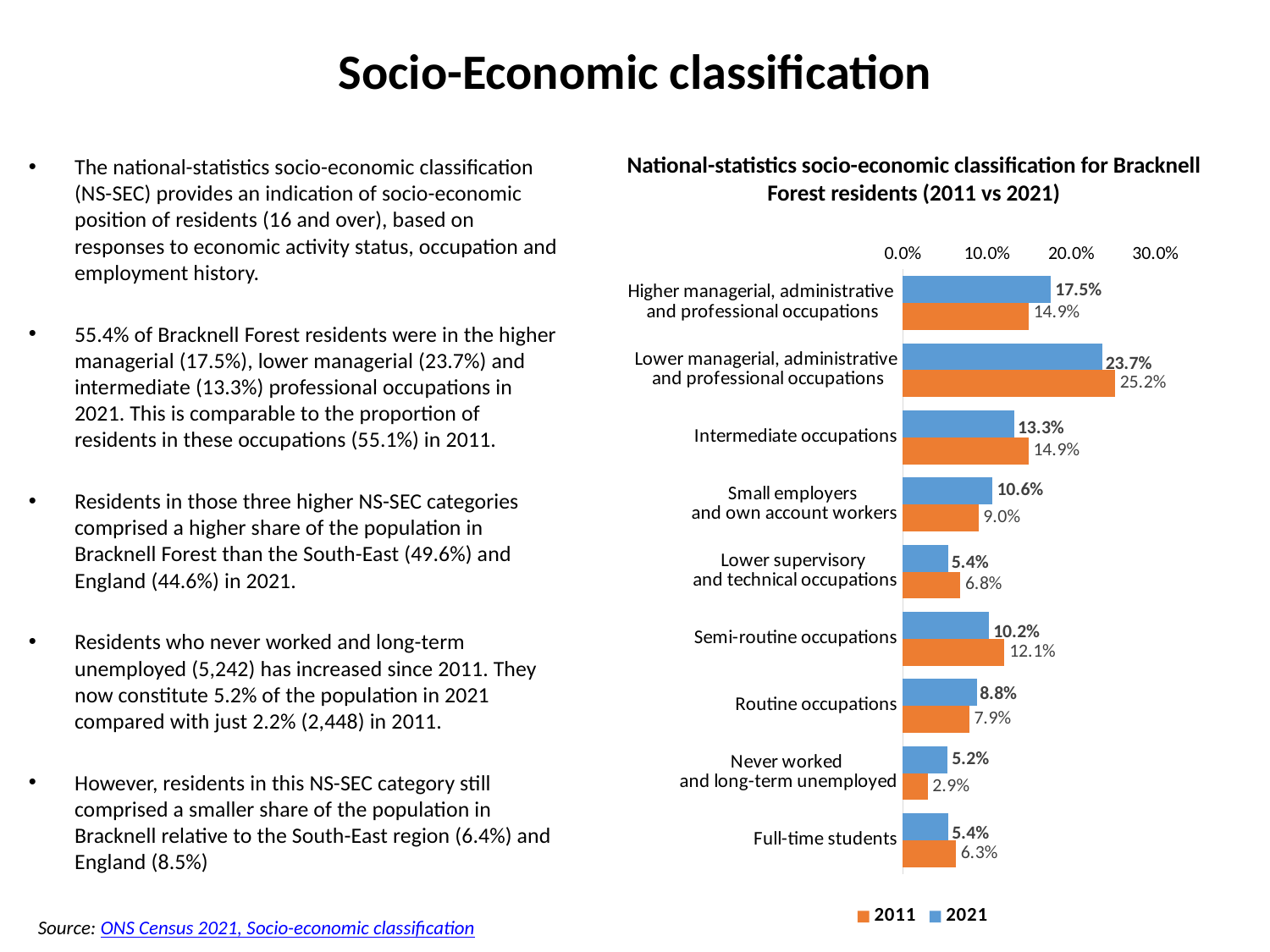
What was the 2011 value for lower managerial, administrative and professional occupations? 25.2% What type of chart is shown on the slide? Bar chart What was the 2011 value for never worked and long-term unemployed? 2.9% What is the difference between the 2021 and 2011 values for never worked and long-term unemployed? 2.3% How many occupation categories are shown in the chart? 9 What is the difference between the 2011 and 2021 values for semi-routine occupations? 1.9% How many series does the chart legend list? 2 Which category had the highest value in 2021? Lower managerial, administrative and professional occupations Which is larger for full-time students: the 2011 value or the 2021 value? 2011 Which is larger for routine occupations: the 2011 value or the 2021 value? 2021 Which category had the lowest value in 2011? Never worked and long-term unemployed What was the share of Bracknell Forest residents in higher managerial, administrative and professional occupations in 2021? 17.5%